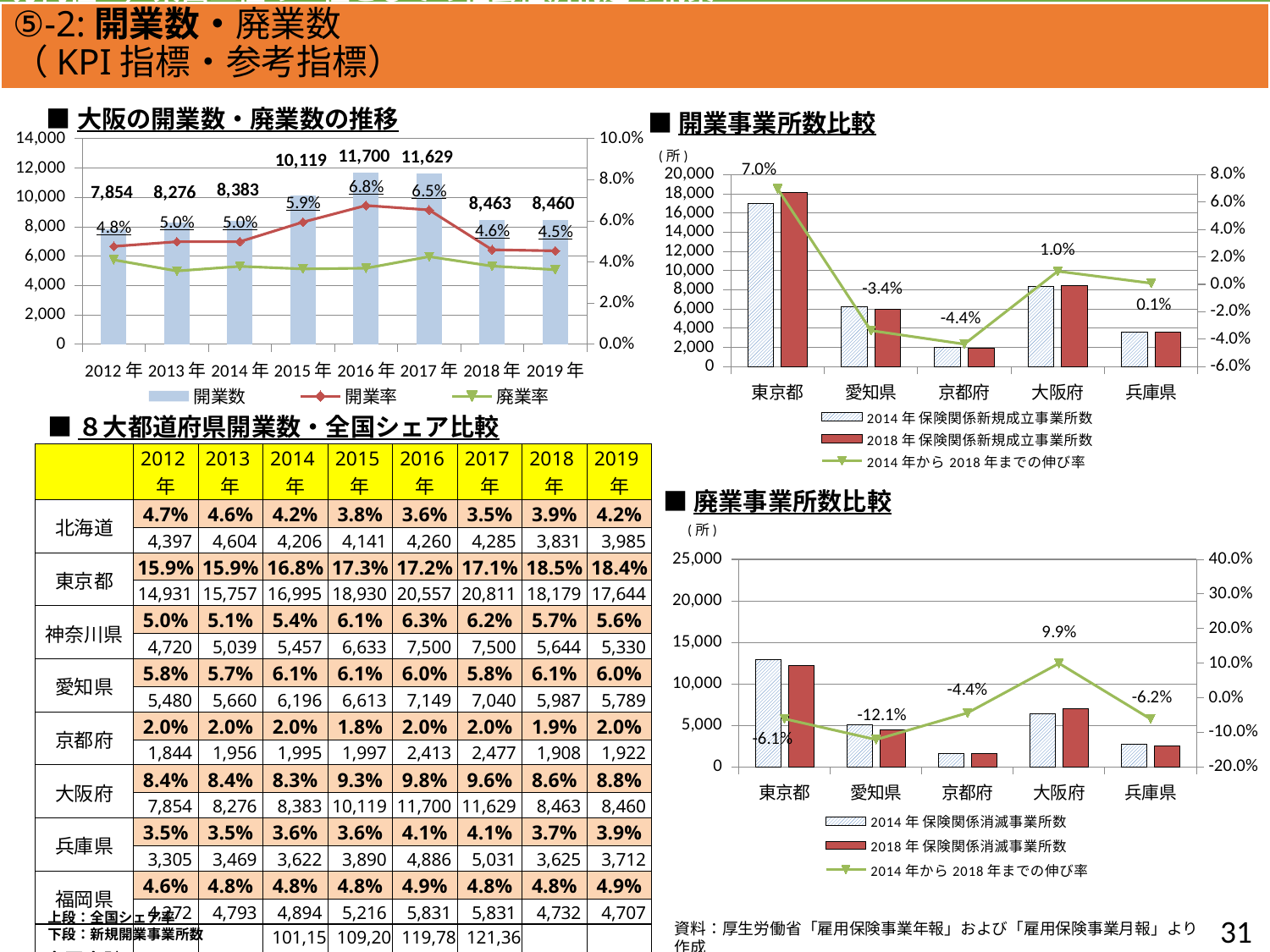
In the chart titled 大阪の開業数・廃業数の推移, what is the difference between the 開業数 for 2017年 and 2018年? 3,166 In the chart titled 開業事業所数比較, which prefecture has the lowest 2014年から2018年までの伸び率? 京都府 In the chart titled 廃業事業所数比較, which prefecture has the lowest 2014年から2018年までの伸び率? 愛知県 In the chart titled 大阪の開業数・廃業数の推移, which is larger, the 開業率 for 2012年 or for 2019年? 2012年 In the chart titled 廃業事業所数比較, what is the 2014年から2018年までの伸び率 for 大阪府? 9.9% In the chart titled 大阪の開業数・廃業数の推移, what is the 開業率 for 2015年? 5.9% In the chart titled 開業事業所数比較, what is the 2014年から2018年までの伸び率 for 東京都? 7.0% In the chart titled 大阪の開業数・廃業数の推移, what is the 開業数 value for 2016年? 11,700 In the chart titled 大阪の開業数・廃業数の推移, which year has the highest 開業数? 2016年 In the chart titled 大阪の開業数・廃業数の推移, how many series does the legend list? 3 In the chart titled 大阪の開業数・廃業数の推移, how many years are shown on the x axis? 8 In the chart titled 開業事業所数比較, is the 2014年保険関係新規成立事業所数 bar for 東京都 greater or less than 14,000? greater